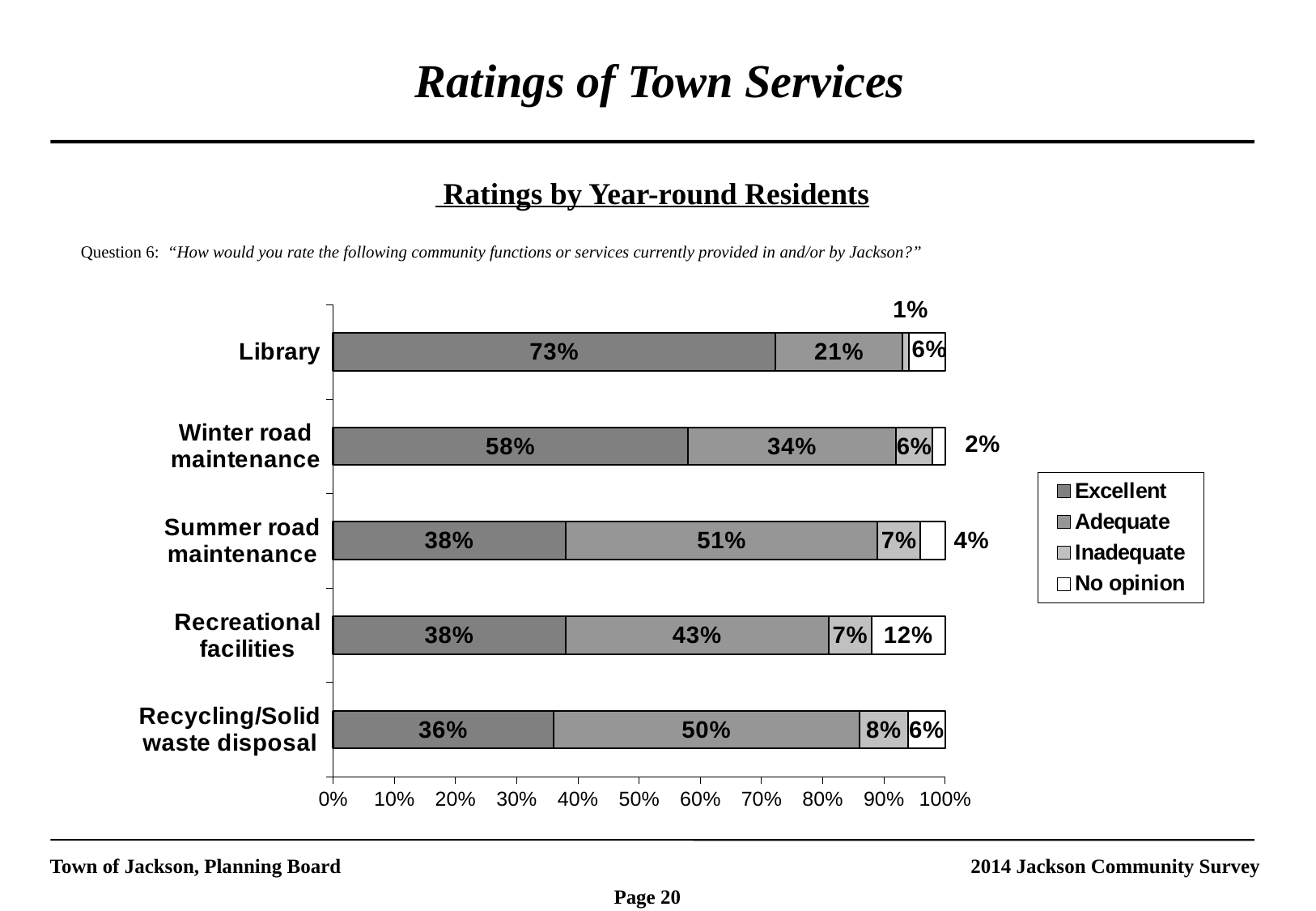
What percentage of year-round residents rated the Library as Excellent? 73% What type of chart is shown on the slide? Stacked bar chart What percentage had No opinion on Recreational facilities? 12% What is the difference between the Excellent ratings for Library and Winter road maintenance? 15% What percentage rated Summer road maintenance as Adequate? 51% How many services are rated in the chart? 5 How many rating categories does the legend list? 4 Which service received the lowest Excellent rating? Recycling/Solid waste disposal What is the combined Excellent and Adequate rating for Winter road maintenance? 92% Which service received the highest Excellent rating? Library Which has a larger Adequate rating, Winter road maintenance or Recreational facilities? Recreational facilities What percentage rated Recycling/Solid waste disposal as Inadequate? 8%